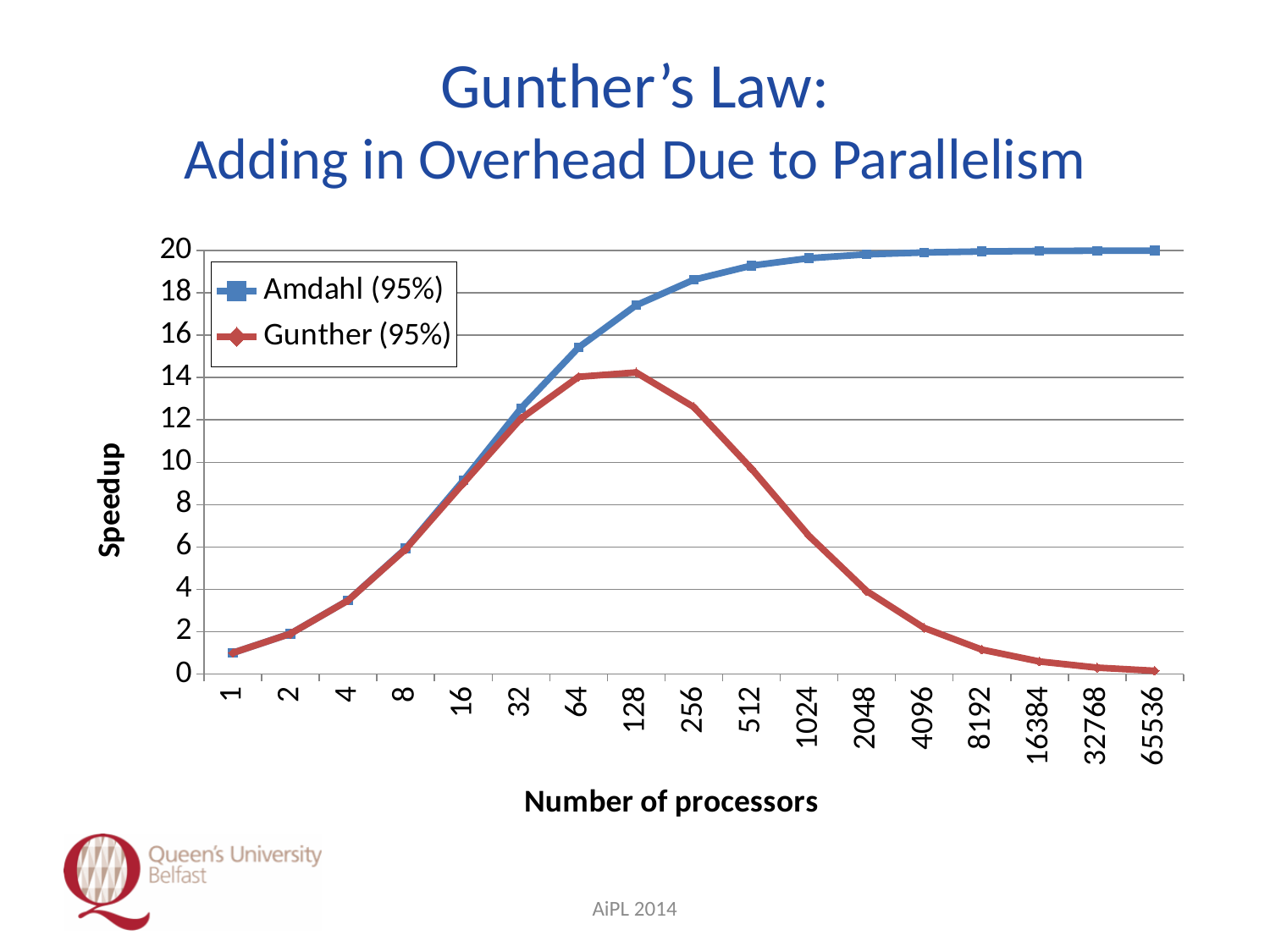
Is the speedup for Amdahl (95%) at 16 processors greater or less than 8? greater How many processor counts are marked along the x axis? 17 How many series does the legend list? 2 Is the speedup for Amdahl (95%) at 65536 processors greater or less than 18? greater What kind of chart is shown on the slide? line chart Is the speedup for Gunther (95%) at 65536 processors greater or less than 2? less What is the label on the y axis? Speedup At which number of processors does the Gunther (95%) series reach its highest speedup? 128 How does the Gunther (95%) speedup change as the number of processors increases beyond 128? it falls At 512 processors, which series has the larger speedup, Amdahl (95%) or Gunther (95%)? Amdahl (95%)